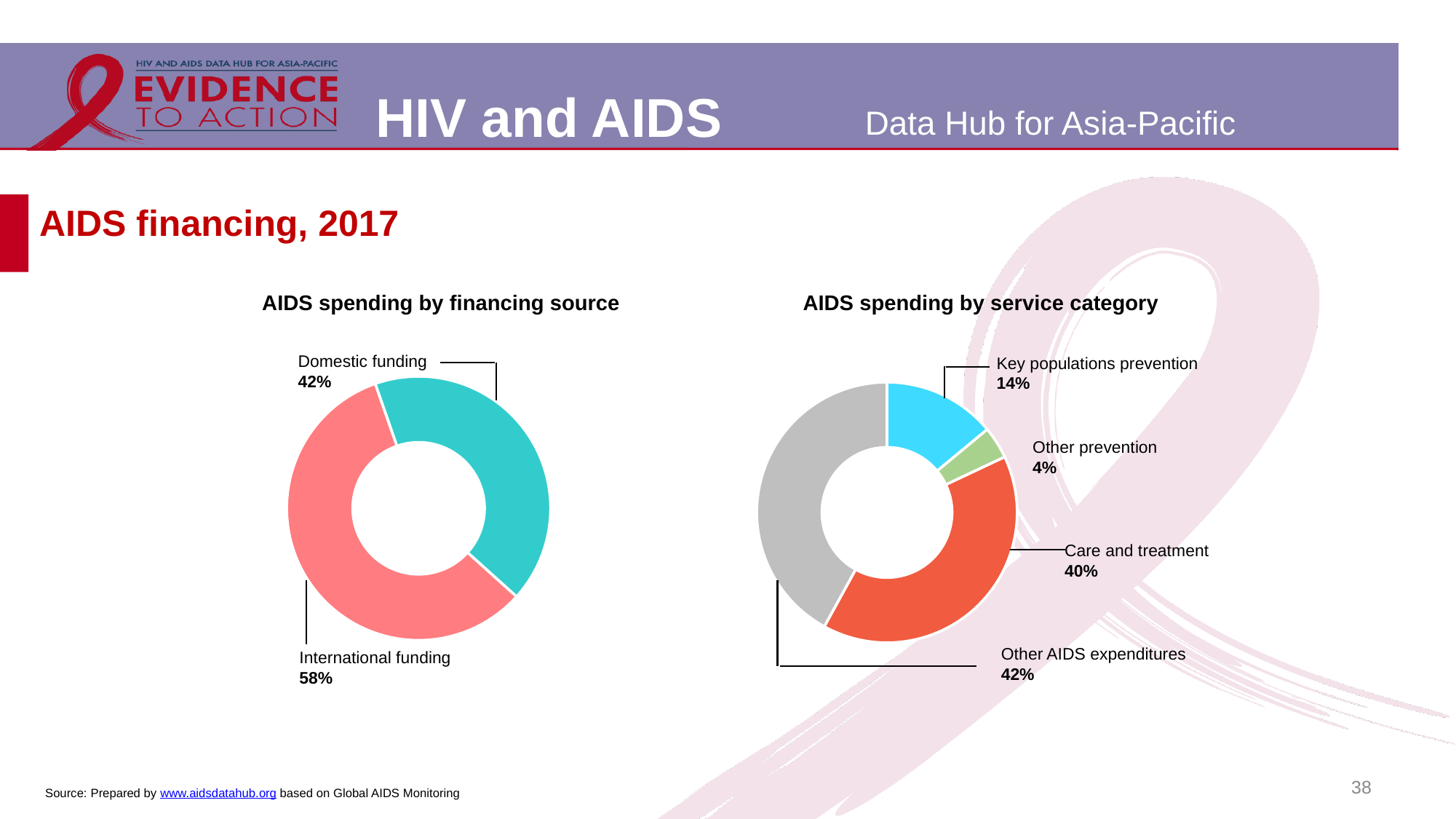
In the 'AIDS spending by service category' chart, what share is Care and treatment? 40% In the 'AIDS spending by financing source' chart, what is the difference in percentage points between International funding and Domestic funding? 16 percentage points In the 'AIDS spending by financing source' chart, which financing source has the larger share? International funding In the 'AIDS spending by financing source' chart, what share is Domestic funding? 42% What type of chart is used for 'AIDS spending by financing source'? Doughnut (pie) chart In the 'AIDS spending by service category' chart, which service category has the smallest share? Other prevention In the 'AIDS spending by financing source' chart, what share is International funding? 58% In the 'AIDS spending by service category' chart, what share is Other prevention? 4% In the 'AIDS spending by service category' chart, how many service categories are shown? 4 In the 'AIDS spending by service category' chart, which is larger: Key populations prevention or Other prevention? Key populations prevention In the 'AIDS spending by service category' chart, what share is Key populations prevention? 14% In the 'AIDS spending by service category' chart, which service category has the largest share? Other AIDS expenditures